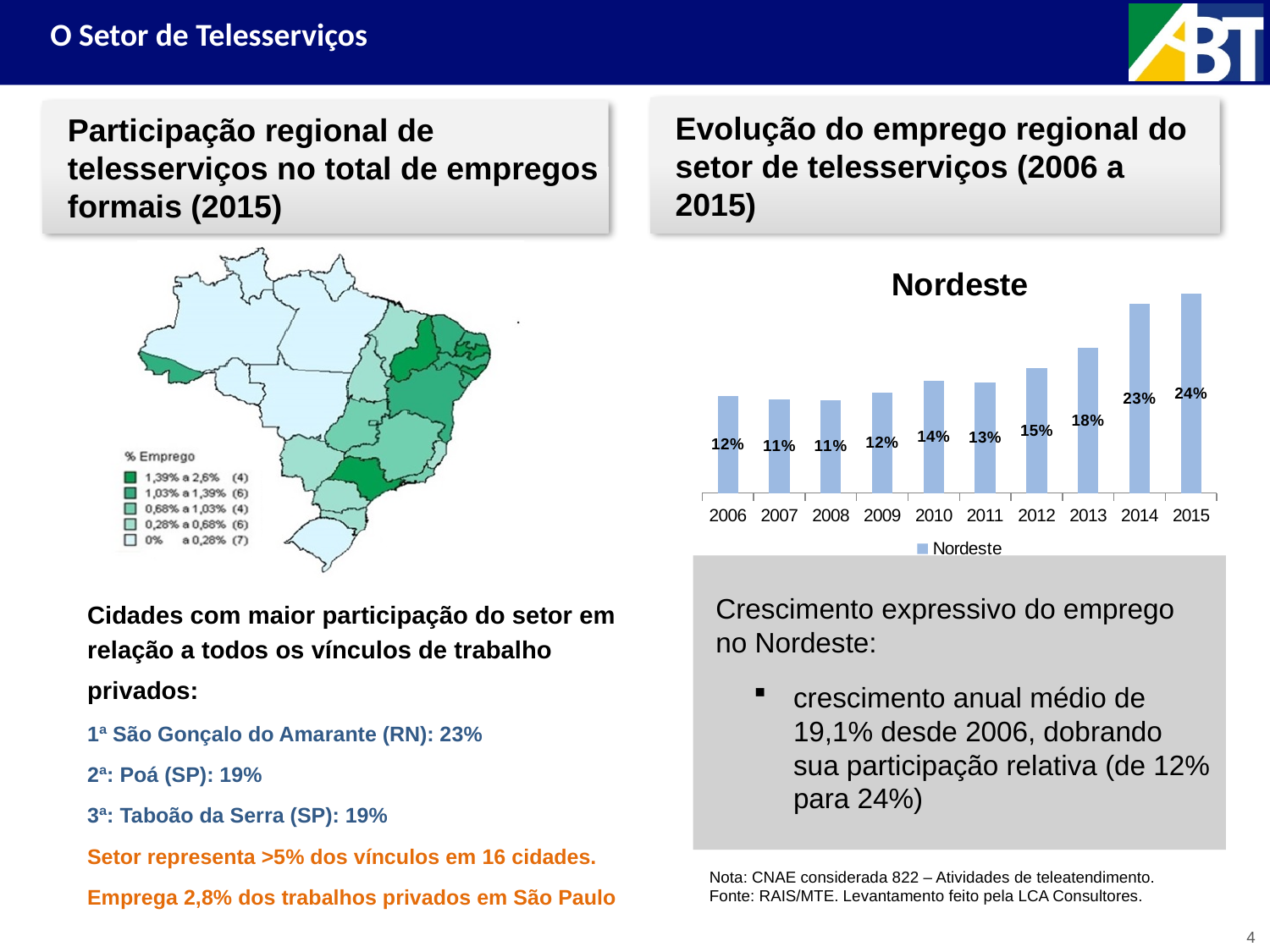
In the Nordeste chart, what is the value for 2013? 18% In the Nordeste chart, what is the lowest value shown? 11% In the Nordeste chart, what is the difference between the values for 2015 and 2006? 12% In the Nordeste chart, what is the difference between the values for 2014 and 2013? 5% How many series does the legend of the Nordeste chart list? 1 In the Nordeste chart, which year has the highest value? 2015 What kind of chart is the Nordeste chart? Bar chart In the Nordeste chart, what is the value for 2015? 24% How many years are shown on the x axis of the Nordeste chart? 10 In the Nordeste chart, which is larger, the value for 2011 or the value for 2012? 2012 In the Nordeste chart, what is the value for 2006? 12% In the Nordeste chart, what is the value for 2010? 14%